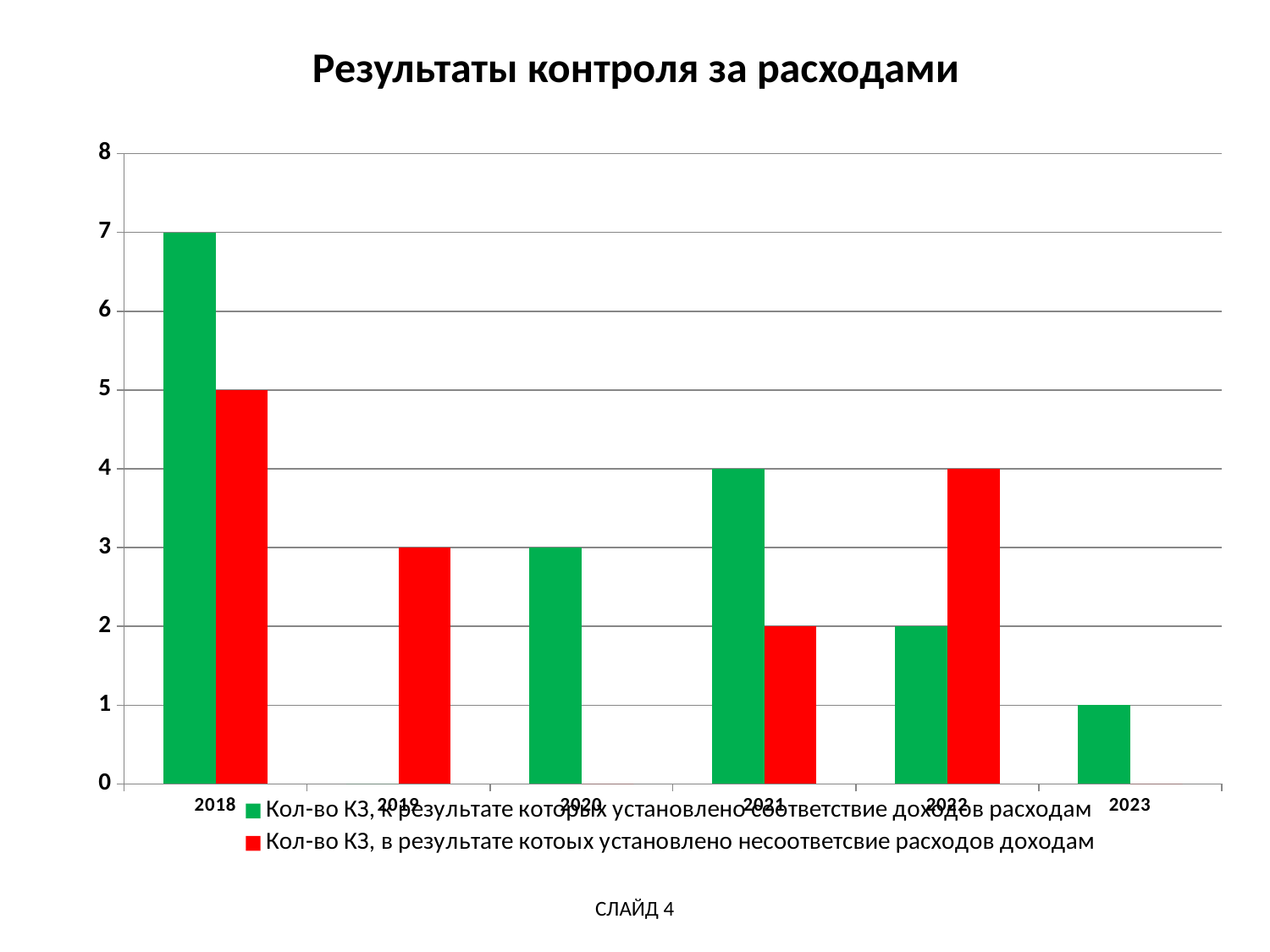
What is the value of the red bar (несоответсвие расходов доходам) for 2019? 3 What is the value of the green bar (соответствие доходов расходам) for 2018? 7 How many years are shown on the x axis? 6 What is the title of the chart? Результаты контроля за расходами What is the difference between the green and red bars in 2018? 2 Which colour represents the series 'Кол-во КЗ, в результате котоых установлено несоответсвие расходов доходам'? red How many series does the legend list? 2 In 2022, which bar is larger, the green one or the red one? the red one In which year is the red bar (несоответсвие расходов доходам) highest? 2018 In which year is the green bar (соответствие доходов расходам) highest? 2018 What kind of chart is shown on the slide? bar chart What is the value of the red bar (несоответсвие расходов доходам) for 2022? 4